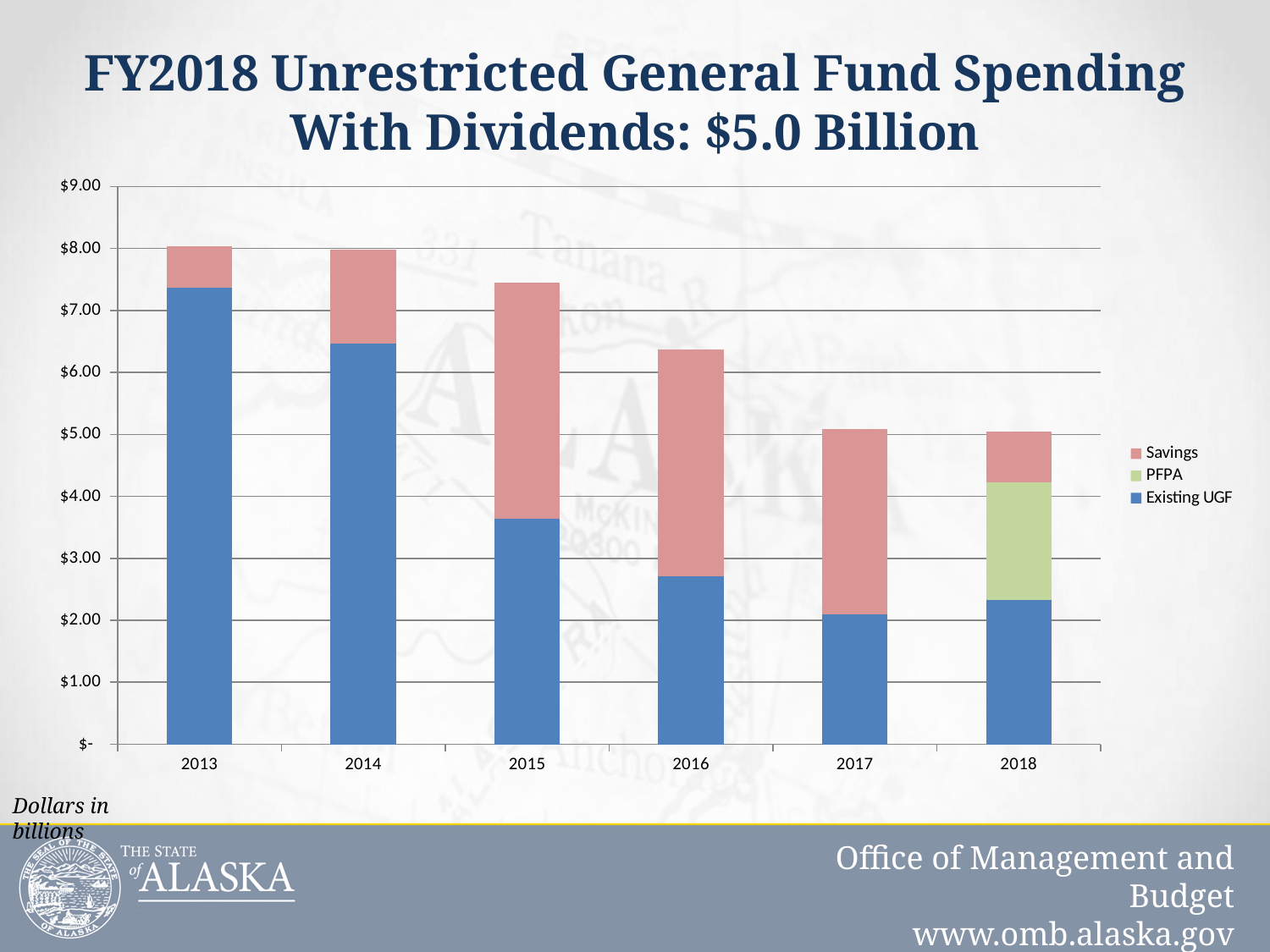
Which is larger, the Existing UGF value for 2014 or for 2015? 2014 Is the Existing UGF value for 2016 greater or less than $3.00? less Is the total bar height for 2016 greater or less than $6.00? greater What are the three series listed in the chart's legend? Savings, PFPA, Existing UGF Which year is the only one with a PFPA segment in its bar? 2018 Which year has the largest Existing UGF value? 2013 Is the Existing UGF value for 2013 greater or less than $7.00? greater Which year has the smallest Existing UGF value? 2017 How many series does the chart's legend list? 3 What kind of chart is shown on the slide? Stacked bar chart How many years are shown on the x axis of the chart? 6 Do the total bar heights generally rise or fall from 2013 to 2018? fall